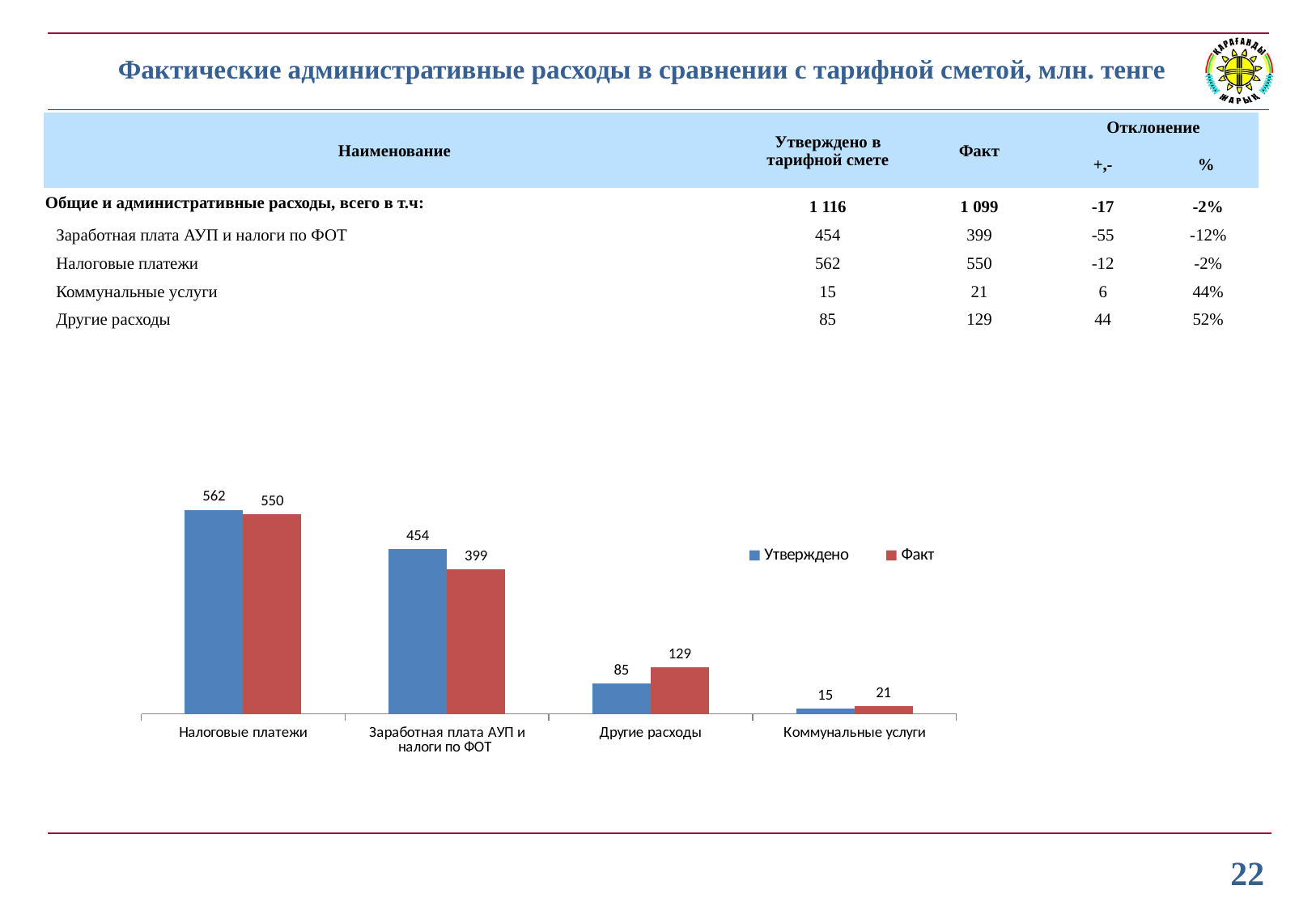
What type of chart is shown on the slide? Bar chart What is the Утверждено value for Налоговые платежи in the chart? 562 What colour are the Факт bars in the chart? Red Which category has the highest Утверждено value in the chart? Налоговые платежи What is the Утверждено value for Коммунальные услуги in the chart? 15 What is the Факт value for Другие расходы in the chart? 129 Which category has the lowest Факт value in the chart? Коммунальные услуги How many series does the chart legend list? 2 What is the difference between the Утверждено and Факт values for Заработная плата АУП и налоги по ФОТ in the chart? 55 For Другие расходы, which is larger in the chart: Утверждено or Факт? Факт What is the Факт value for Заработная плата АУП и налоги по ФОТ in the chart? 399 How many categories are shown on the x axis of the chart? 4